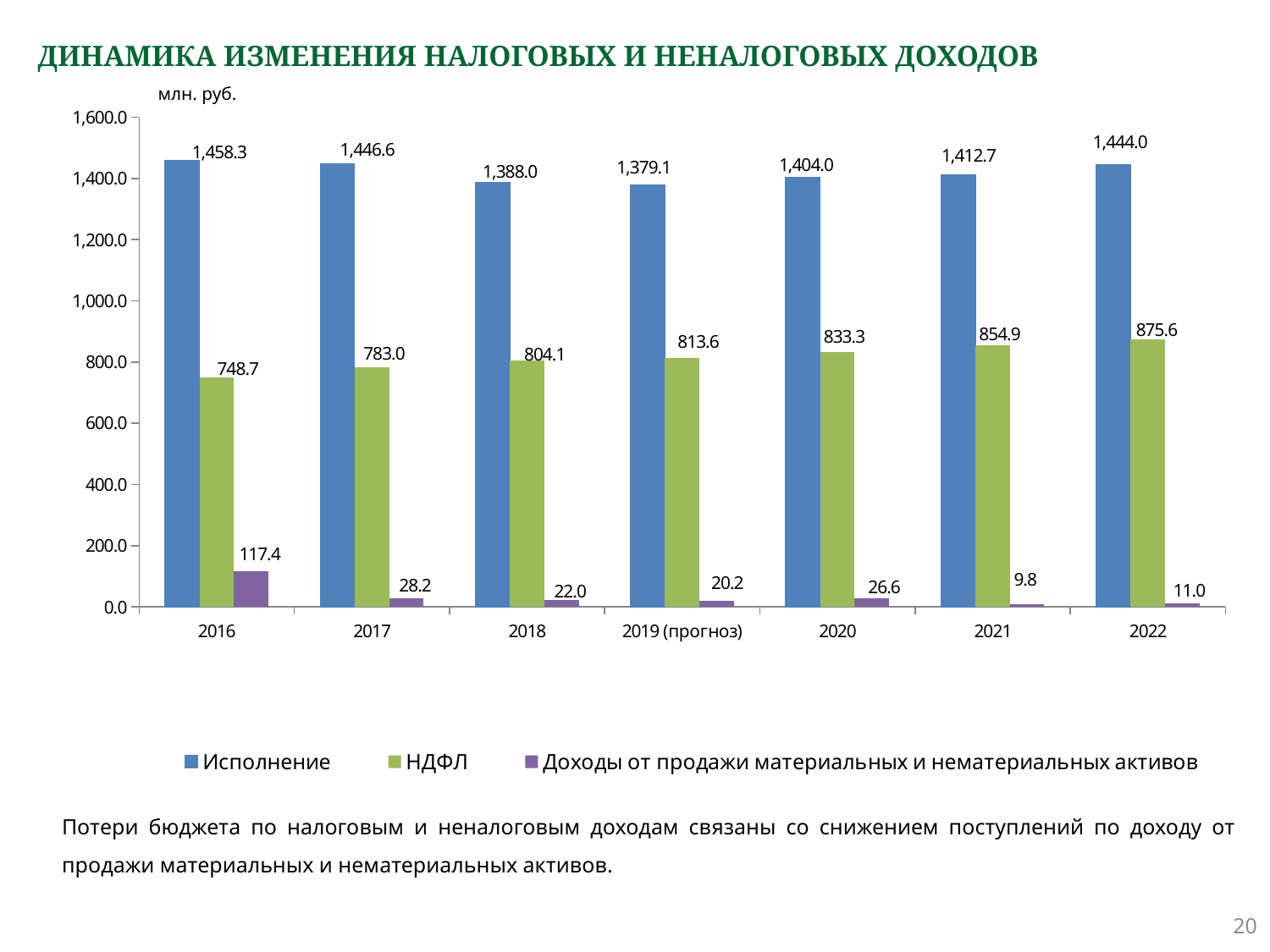
What is the difference between the НДФЛ values for 2022 and 2016? 126.9 Which is larger: Исполнение for 2017 or Исполнение for 2022? 2017 What kind of chart is shown on the slide? bar chart What unit is shown above the vertical axis? млн. руб. What is the value of НДФЛ for 2020? 833.3 What is the value of Исполнение for 2016? 1,458.3 Which year has the highest value for НДФЛ? 2022 What is the value of Доходы от продажи материальных и нематериальных активов for 2021? 9.8 Which year has the lowest value for Исполнение? 2019 (прогноз) How many series does the legend list? 3 Do the НДФЛ values rise or fall from 2016 to 2022? rise How many years are shown on the x axis? 7